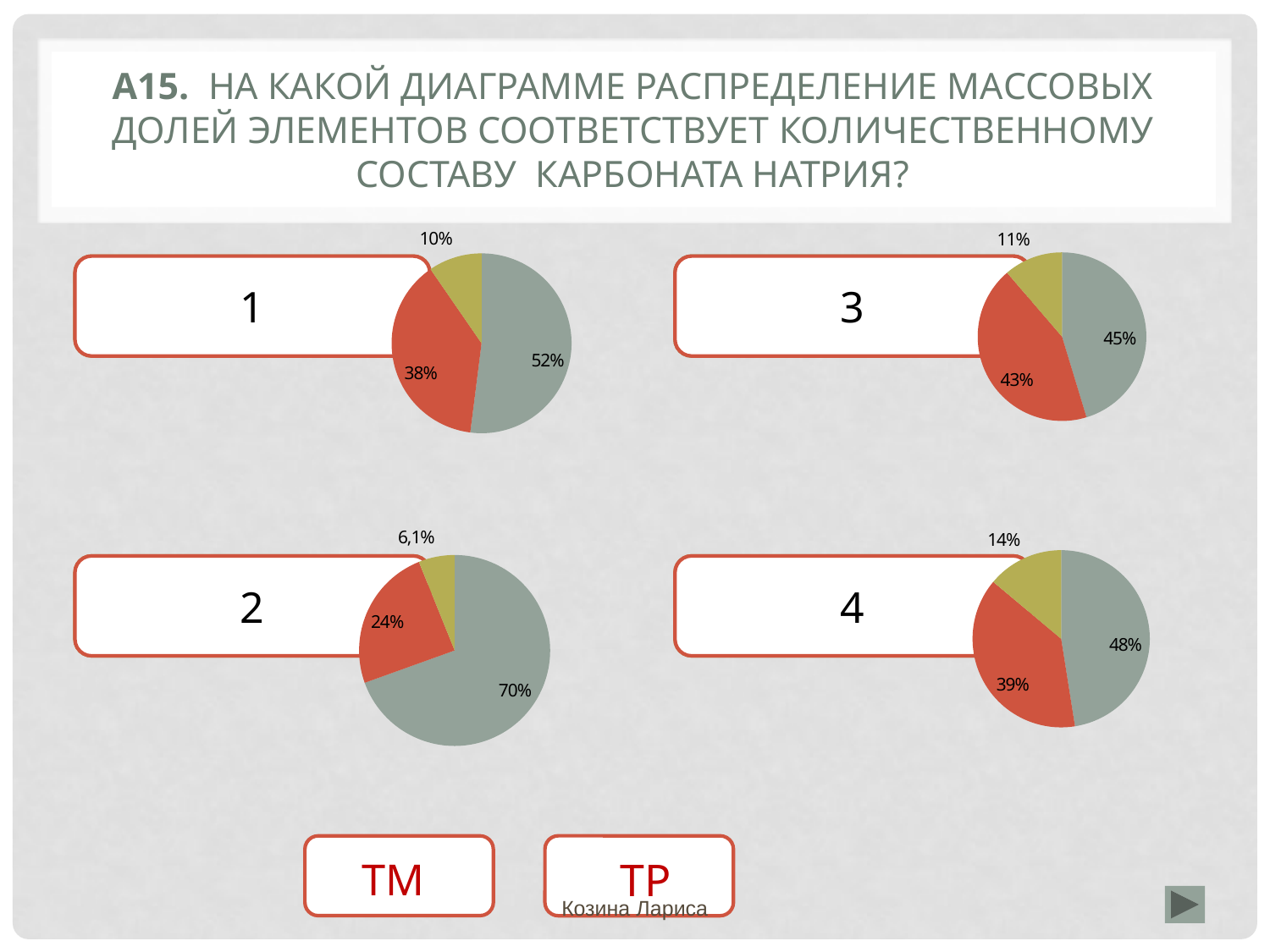
Which pie chart has the largest single slice? Pie chart 2 (70%) What is the number shown in the box next to the pie chart with the 70% slice? 2 In pie chart 3, what is the value of the red slice? 43% In pie chart 4, what is the value of the yellow slice? 14% In pie chart 1, what is the value of the largest slice? 52% In pie chart 3, what is the difference between the grey slice and the red slice? 2% In pie chart 1, what is the difference between the largest slice and the red slice? 14% In pie chart 4, which is larger: the grey slice or the red slice? The grey slice (48%) What type of charts are shown on the slide? Pie charts How many pie charts are on the slide? 4 How many slices does pie chart 2 have? 3 In pie chart 2, what is the value of the smallest slice? 6,1%